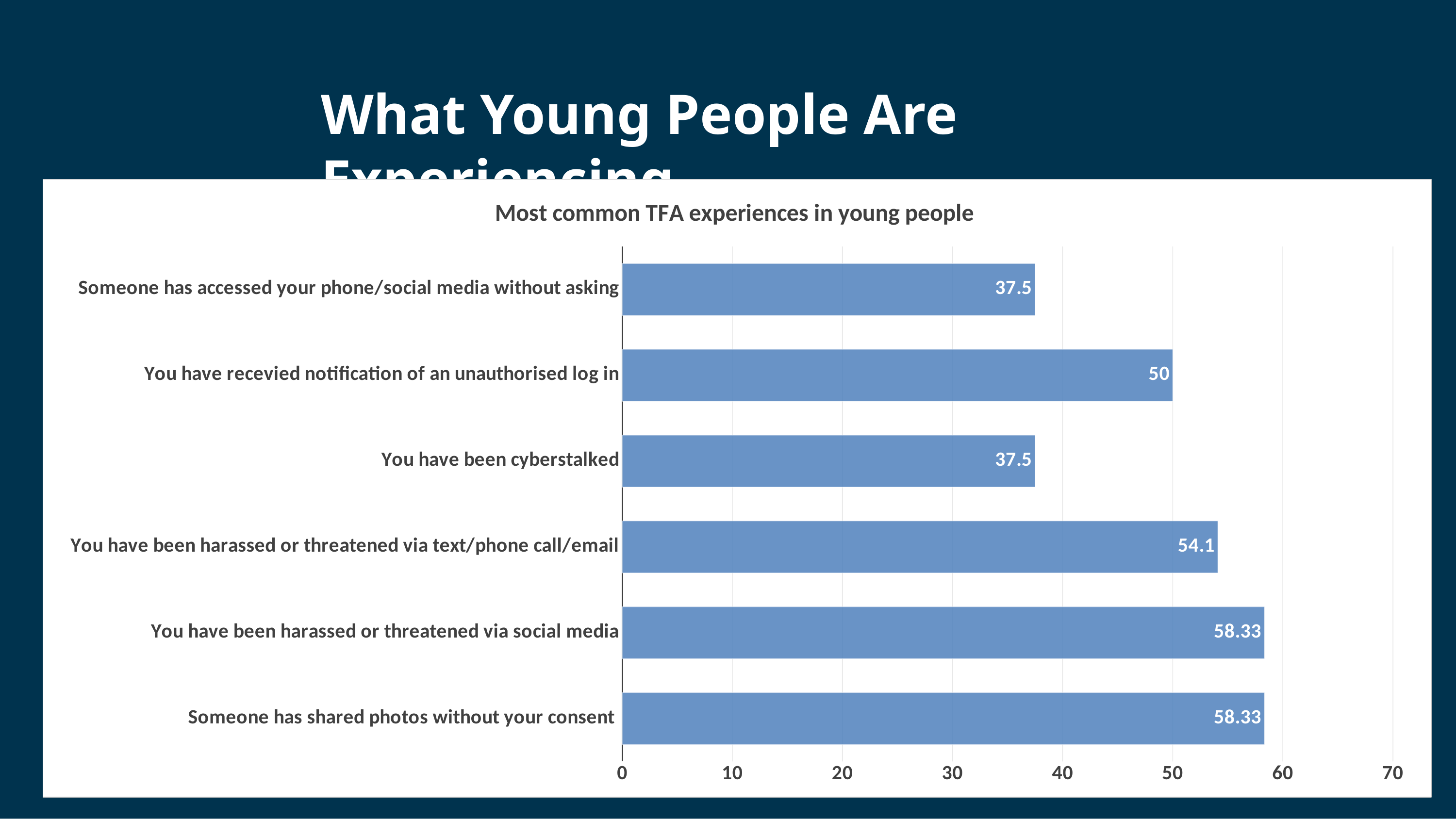
What is the value for "You have been harassed or threatened via text/phone call/email"? 54.1 What is the value for "You have been cyberstalked"? 37.5 What is the value for "Someone has shared photos without your consent"? 58.33 What is the lowest value shown in the chart? 37.5 What kind of chart is shown on the slide? Bar chart What is the value for "You have received notification of an unauthorised log in"? 50 Which is larger: the value for "You have received notification of an unauthorised log in" or the value for "You have been harassed or threatened via text/phone call/email"? You have been harassed or threatened via text/phone call/email What is the title of the chart? Most common TFA experiences in young people What is the value for "Someone has accessed your phone/social media without asking"? 37.5 How many categories are shown in the chart? 6 What is the highest value shown in the chart? 58.33 What is the difference between the value for "You have been harassed or threatened via social media" and the value for "You have been cyberstalked"? 20.83